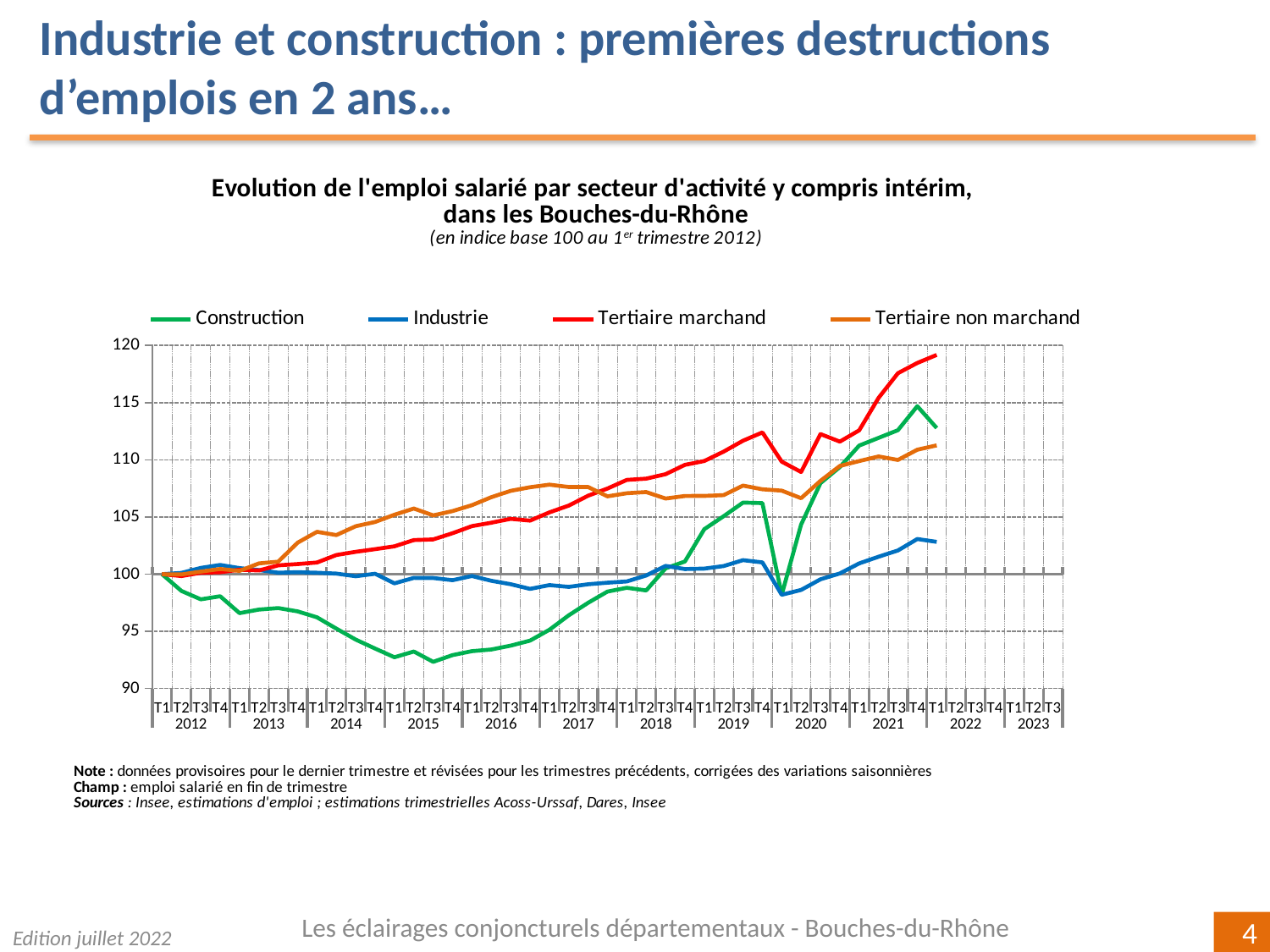
Which series is represented by the green line? Construction How many series does the legend list? 4 What type of chart is shown on the slide? line chart What is the index value of all series at T1 2012, the base quarter? 100 Is the value for Tertiaire non marchand at T1 2017 greater or less than 105? greater Is the value for Tertiaire marchand at T1 2022 greater or less than 115? greater Which series has the highest value at T1 2022? Tertiaire marchand Is the value for Industrie at T1 2020 greater or less than 100? less Which series has the lowest value at T3 2015? Construction Does the Tertiaire marchand series generally rise or fall from 2012 to 2022? rise Which series has the lowest value at T1 2022? Industrie